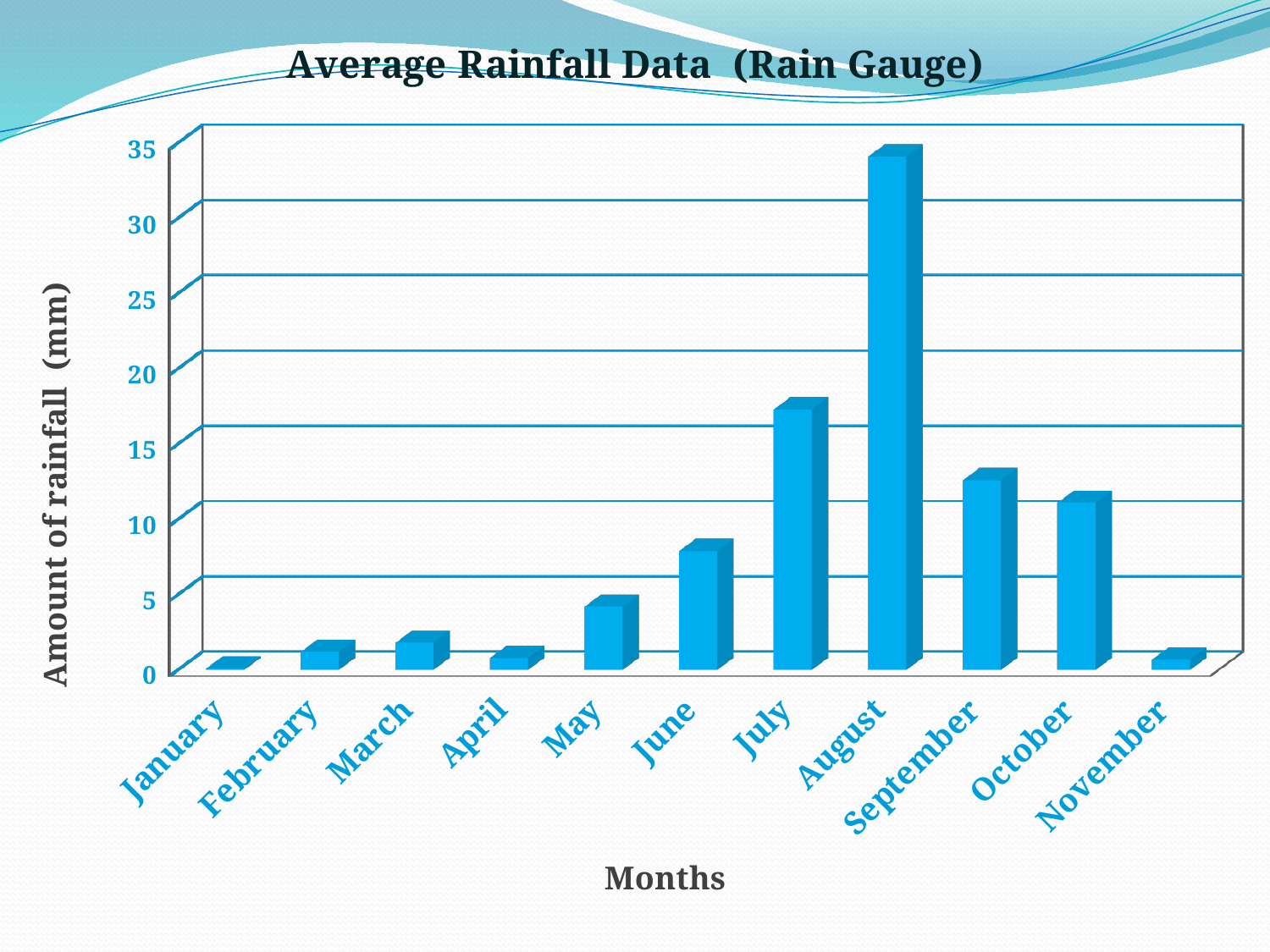
Is the value for September greater or less than 10? greater What type of chart is shown on the slide? Bar chart Is the value for July greater or less than 15? greater Is the value for May greater or less than 5? less Do the values generally rise or fall from January to August? Rise Which month has more rainfall, May or June? June What is the label on the y axis? Amount of rainfall (mm) Which month has more rainfall, July or September? July How many months are shown on the x axis? 11 Which month has the highest average rainfall? August